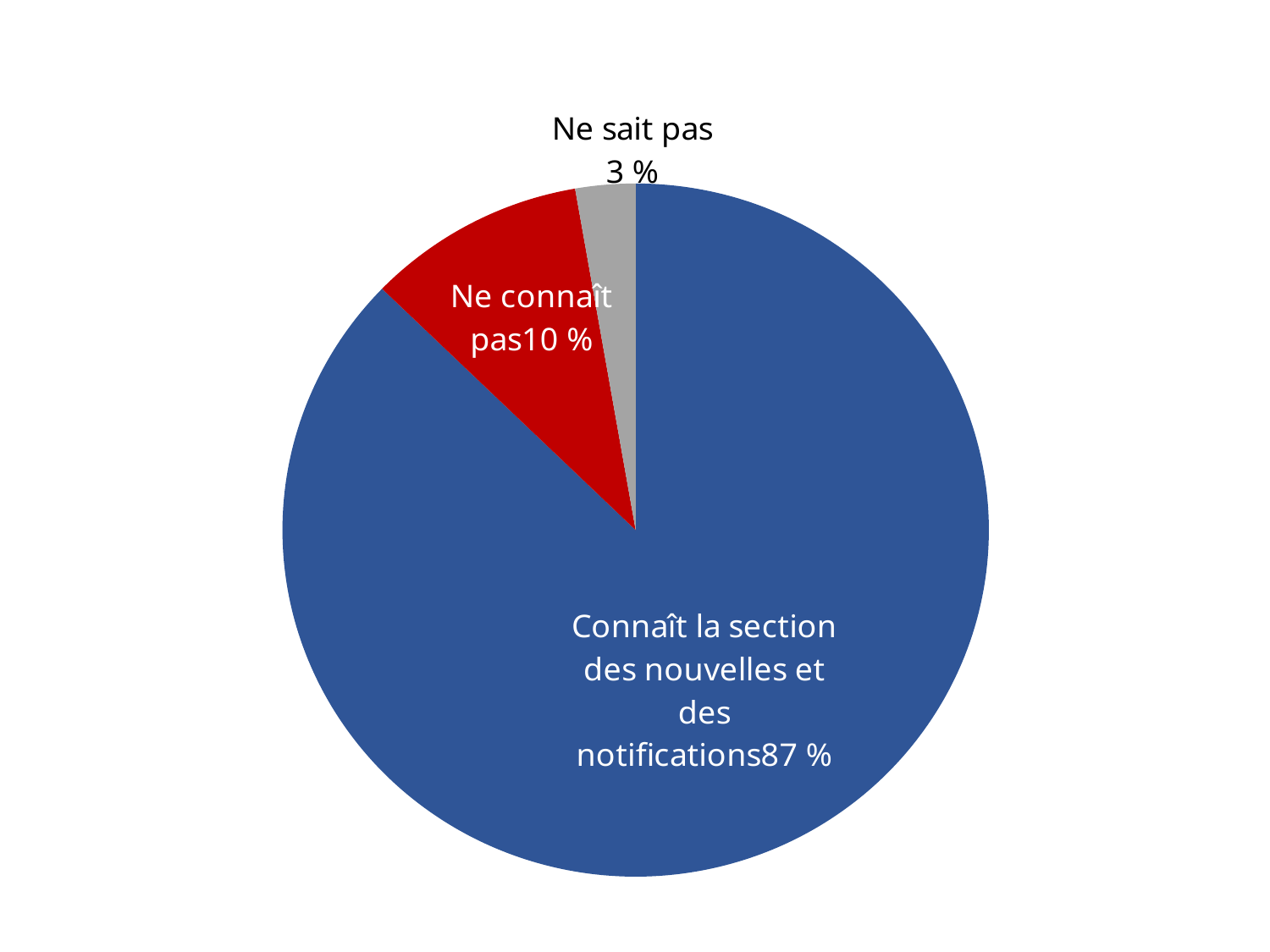
What share of the pie does "Ne connaît pas" represent? 10 % What kind of chart is shown on the slide? pie chart What colour is the "Ne sait pas" slice? grey What colour is the "Ne connaît pas" slice? red What is the difference between the "Ne connaît pas" share and the "Ne sait pas" share? 7 % What is the difference between the "Connaît la section des nouvelles et des notifications" share and the "Ne connaît pas" share? 77 % What share of the pie does "Connaît la section des nouvelles et des notifications" represent? 87 % What share of the pie does "Ne sait pas" represent? 3 % Which slice of the pie is the largest? Connaît la section des nouvelles et des notifications Which is larger, the "Ne connaît pas" slice or the "Ne sait pas" slice? Ne connaît pas Which slice of the pie is the smallest? Ne sait pas How many slices does the pie chart have? 3